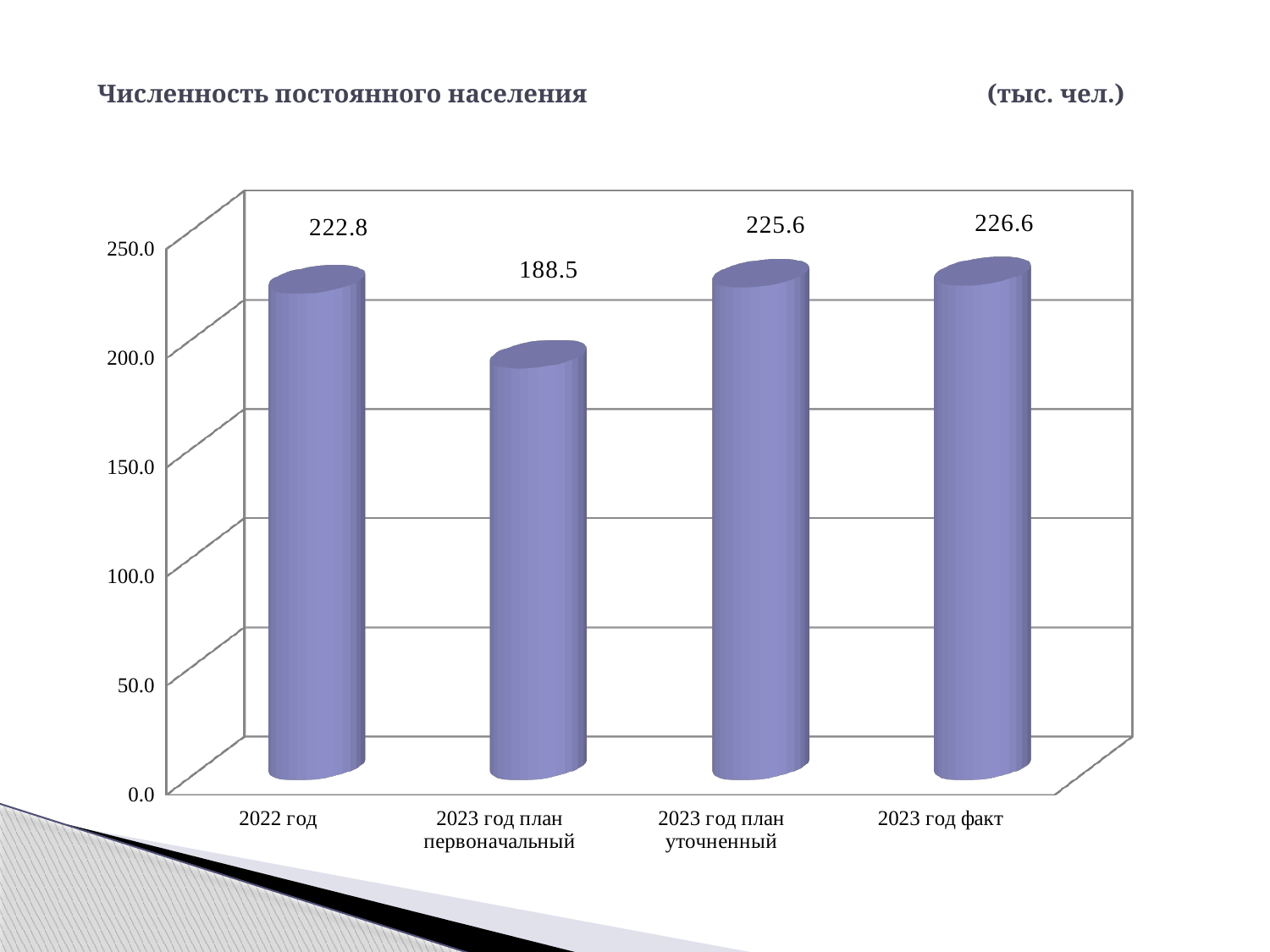
What kind of chart is shown on the slide? bar chart Is the value for 2023 год план первоначальный greater or less than 200.0? less What is the value for 2023 год план первоначальный? 188.5 How many categories are shown on the chart? 4 What is the value for 2023 год факт? 226.6 Which category has the highest value? 2023 год факт What is the difference between the values for 2023 год факт and 2023 год план первоначальный? 38.1 Which category has the lowest value? 2023 год план первоначальный Which is larger, the value for 2022 год or the value for 2023 год план первоначальный? 2022 год What is the difference between the values for 2023 год план уточненный and 2022 год? 2.8 What is the value for 2023 год план уточненный? 225.6 What is the value for 2022 год? 222.8